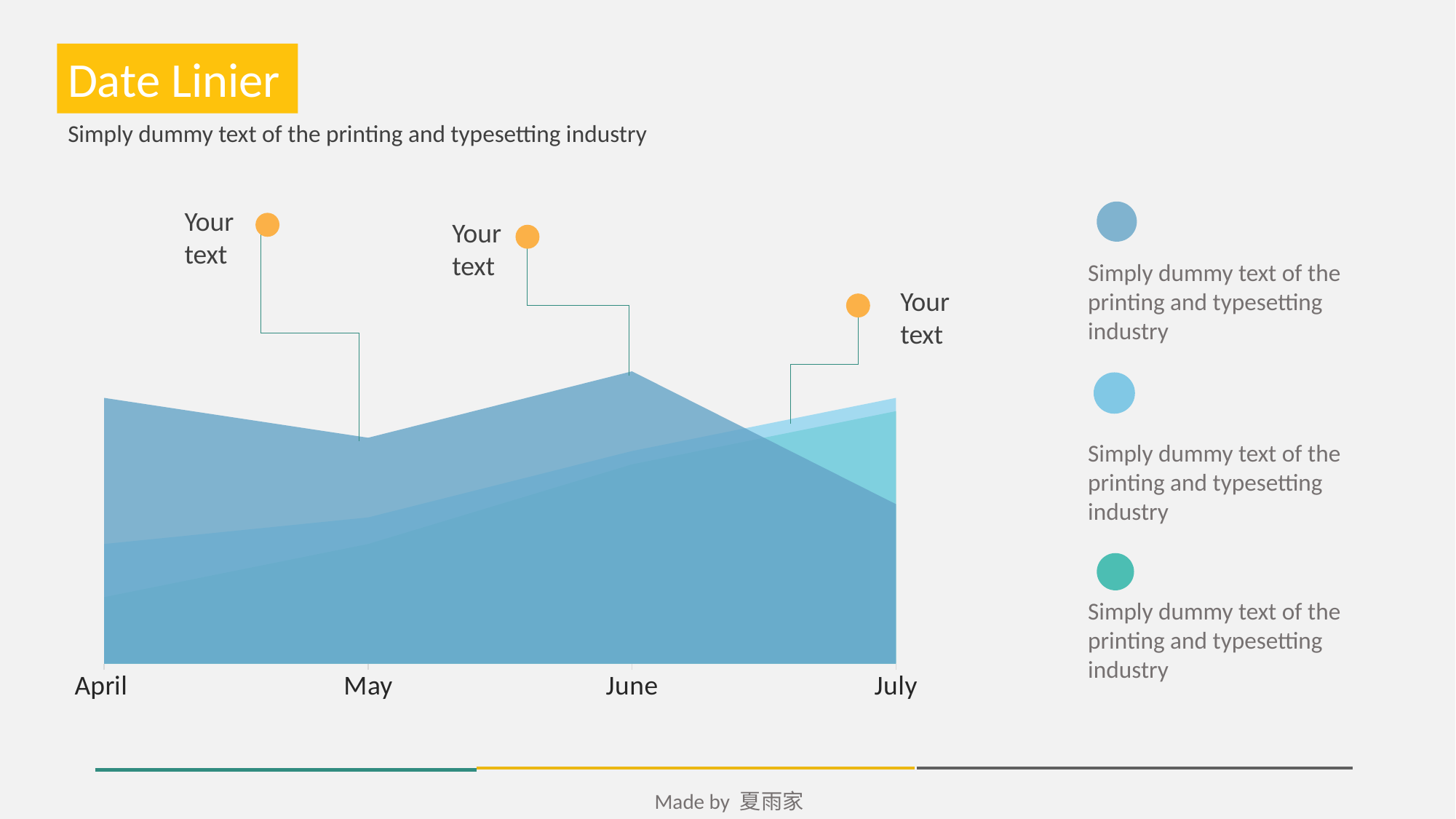
How many categories are shown on the x axis of the chart? 4 What is the first category on the x axis of the chart? April Does the top edge of the chart rise or fall from April to May? Fall What is the title of the slide containing the chart? Date Linier What kind of chart is shown on the slide? Area chart What are the categories on the x axis of the chart? April, May, June, July Does the top edge of the chart rise or fall from May to June? Rise Between which two months does the light blue area appear in the chart? June and July Does the top edge of the chart rise or fall from June to July? Fall How many 'Your text' callout markers point to the chart? 3 At which month does the top edge of the chart reach its highest point? June What is the last category on the x axis of the chart? July